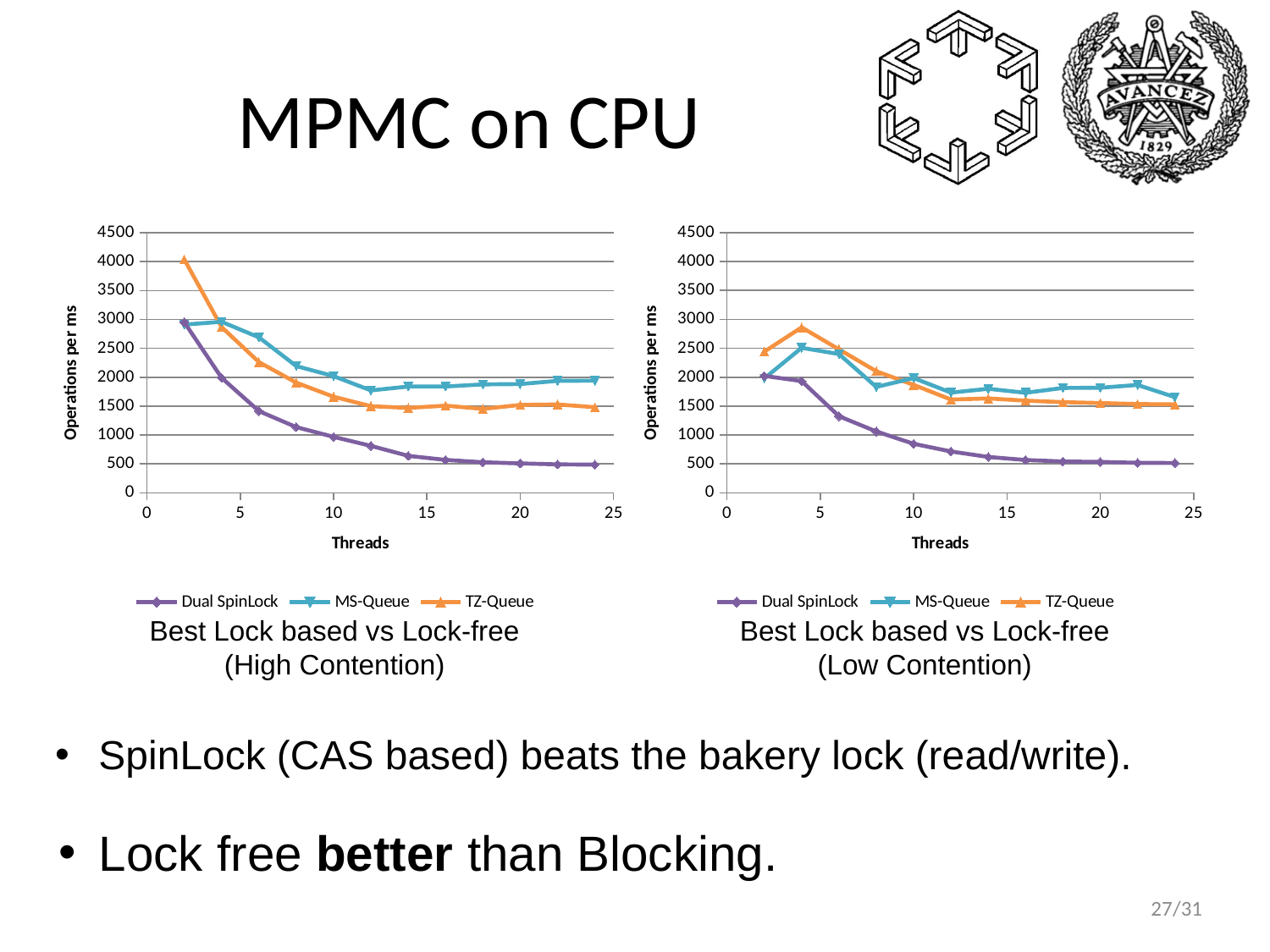
In the 'Best Lock based vs Lock-free (Low Contention)' chart, which series has the highest value at 4 threads? TZ-Queue What kind of chart is the 'Best Lock based vs Lock-free (High Contention)' chart? line chart In the 'Best Lock based vs Lock-free (Low Contention)' chart, what is the label on the y axis? Operations per ms How many series does the legend of the 'Best Lock based vs Lock-free (Low Contention)' chart list? 3 How many data points does the Dual SpinLock series have in the 'Best Lock based vs Lock-free (High Contention)' chart? 12 In the 'Best Lock based vs Lock-free (High Contention)' chart, at 24 threads, which is larger: MS-Queue or Dual SpinLock? MS-Queue In the 'Best Lock based vs Lock-free (High Contention)' chart, is the value for Dual SpinLock at 24 threads greater or less than 1000? less In the 'Best Lock based vs Lock-free (High Contention)' chart, what are the three series named in the legend? Dual SpinLock, MS-Queue, TZ-Queue In the 'Best Lock based vs Lock-free (High Contention)' chart, at 2 threads, which is larger: TZ-Queue or Dual SpinLock? TZ-Queue In the 'Best Lock based vs Lock-free (High Contention)' chart, does the Dual SpinLock series rise or fall as the number of threads increases? fall In the 'Best Lock based vs Lock-free (High Contention)' chart, is the value for TZ-Queue at 2 threads greater or less than 3500? greater In the 'Best Lock based vs Lock-free (Low Contention)' chart, is the value for TZ-Queue at 4 threads greater or less than 2500? greater